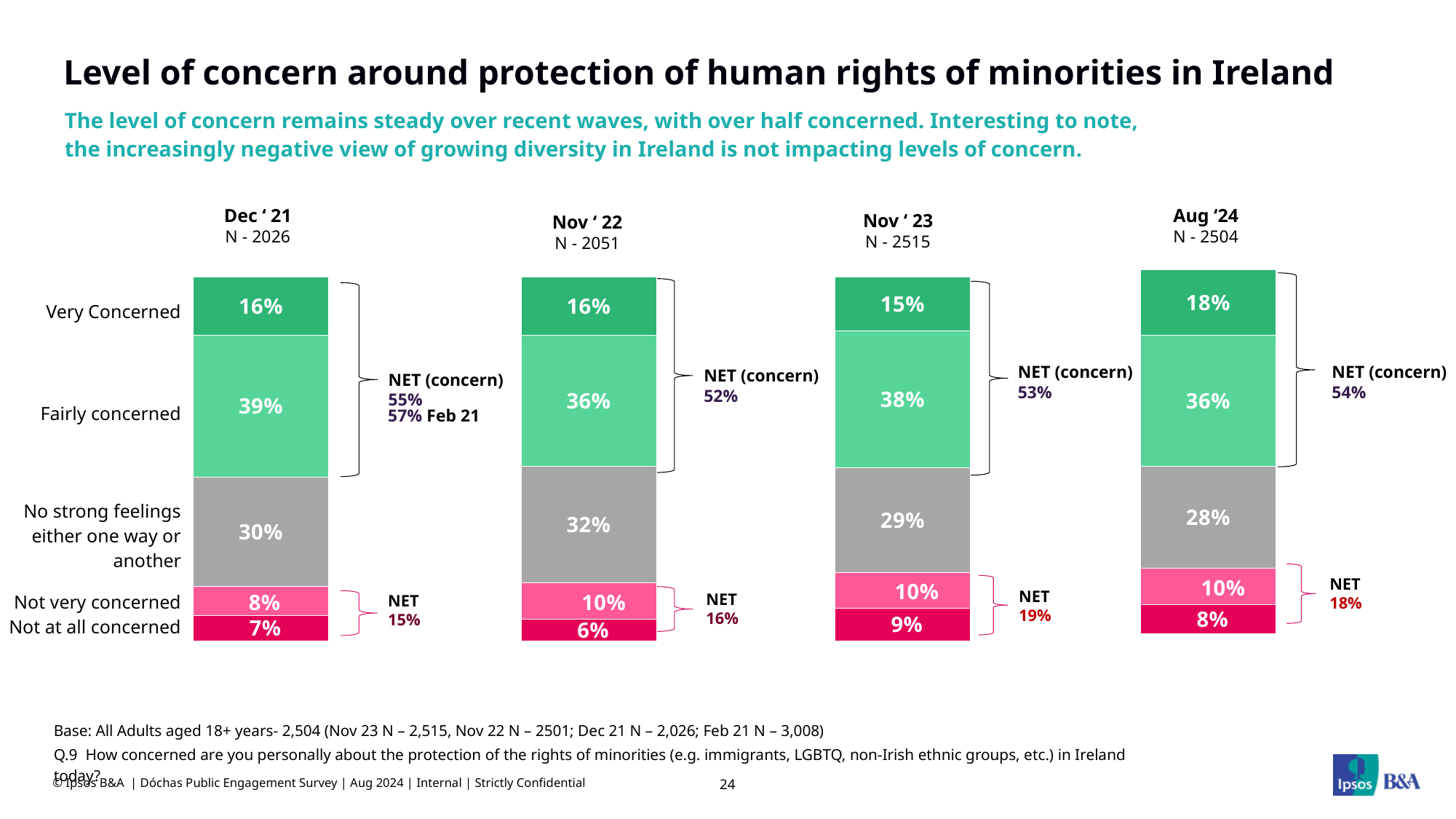
What is the combined share of Not very concerned and Not at all concerned in Aug '24? 18% How many survey waves are shown as bars in the chart? 4 Which is larger: the Not very concerned share in Dec '21 or in Nov '23? Nov '23 What is the sample size (N) shown for the Nov '23 wave? 2515 What is the difference between the Fairly concerned share in Dec '21 and in Nov '22? 3 percentage points What percentage had no strong feelings either one way or another in Nov '22? 32% What percentage of respondents were Very Concerned in Aug '24? 18% What is the NET (concern) figure shown for Nov '23? 53% What percentage of respondents were Fairly concerned in Dec '21? 39% What type of chart is used on this slide? Stacked bar chart In which wave was the Very Concerned share highest? Aug '24 In which wave was the Not at all concerned share lowest? Nov '22